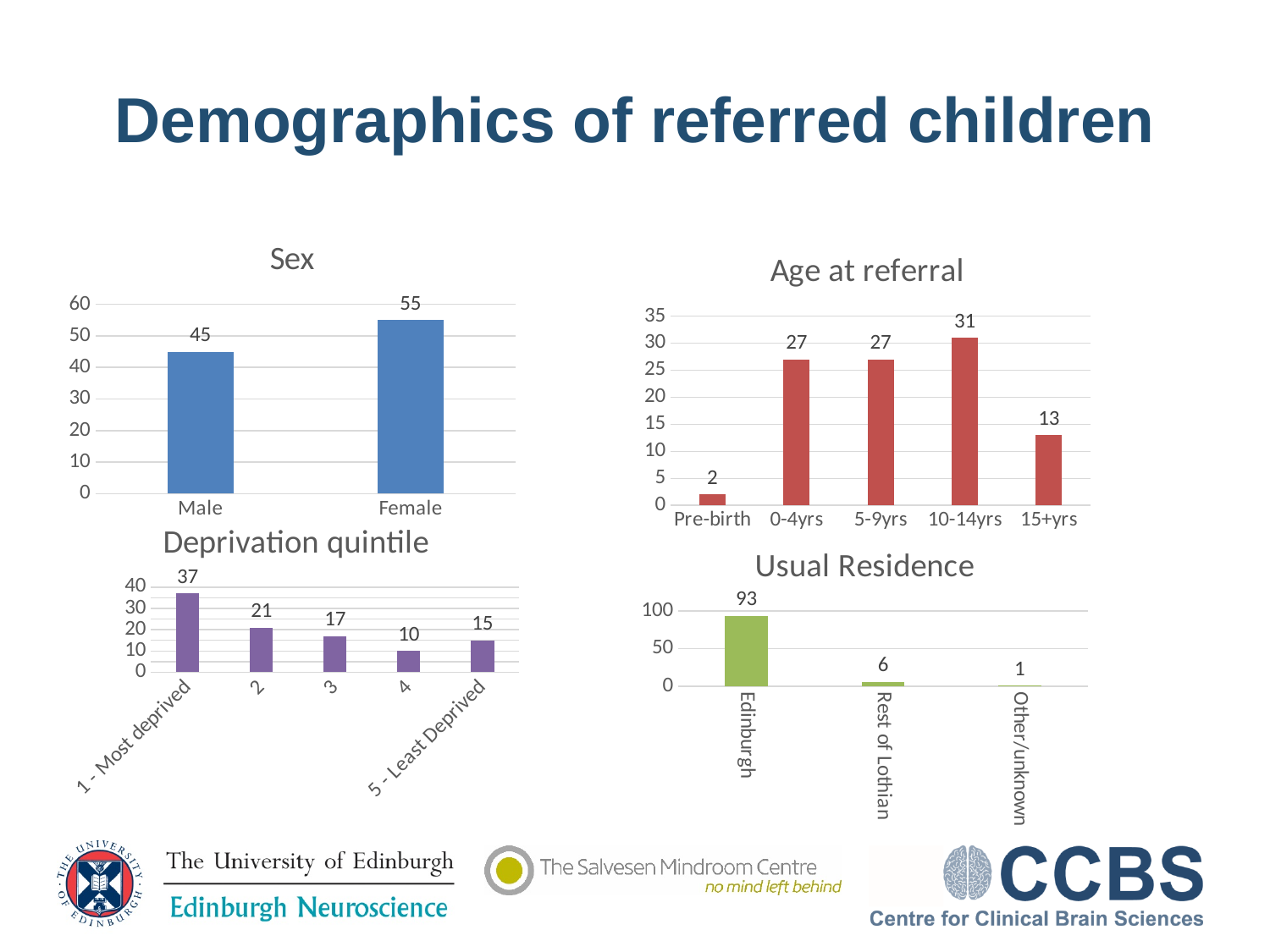
In the 'Usual Residence' chart, what is the difference between the Edinburgh and Other/unknown values? 92 In the 'Deprivation quintile' chart, what is the value for '1 - Most deprived'? 37 In the 'Sex' chart, what is the difference between the Female and Male values? 10 In the 'Age at referral' chart, what is the value for Pre-birth? 2 In the 'Age at referral' chart, how many age categories are shown? 5 In the 'Age at referral' chart, what is the difference between the 10-14yrs and 15+yrs values? 18 In the 'Deprivation quintile' chart, which quintile has the lowest value? 4 In the 'Age at referral' chart, which age group has the highest value? 10-14yrs In the 'Usual Residence' chart, what is the value for Rest of Lothian? 6 In the 'Deprivation quintile' chart, which is larger, the value for quintile 2 or quintile 3? Quintile 2 What kind of chart is the 'Usual Residence' chart? Bar chart In the 'Sex' chart, what is the value for Female? 55